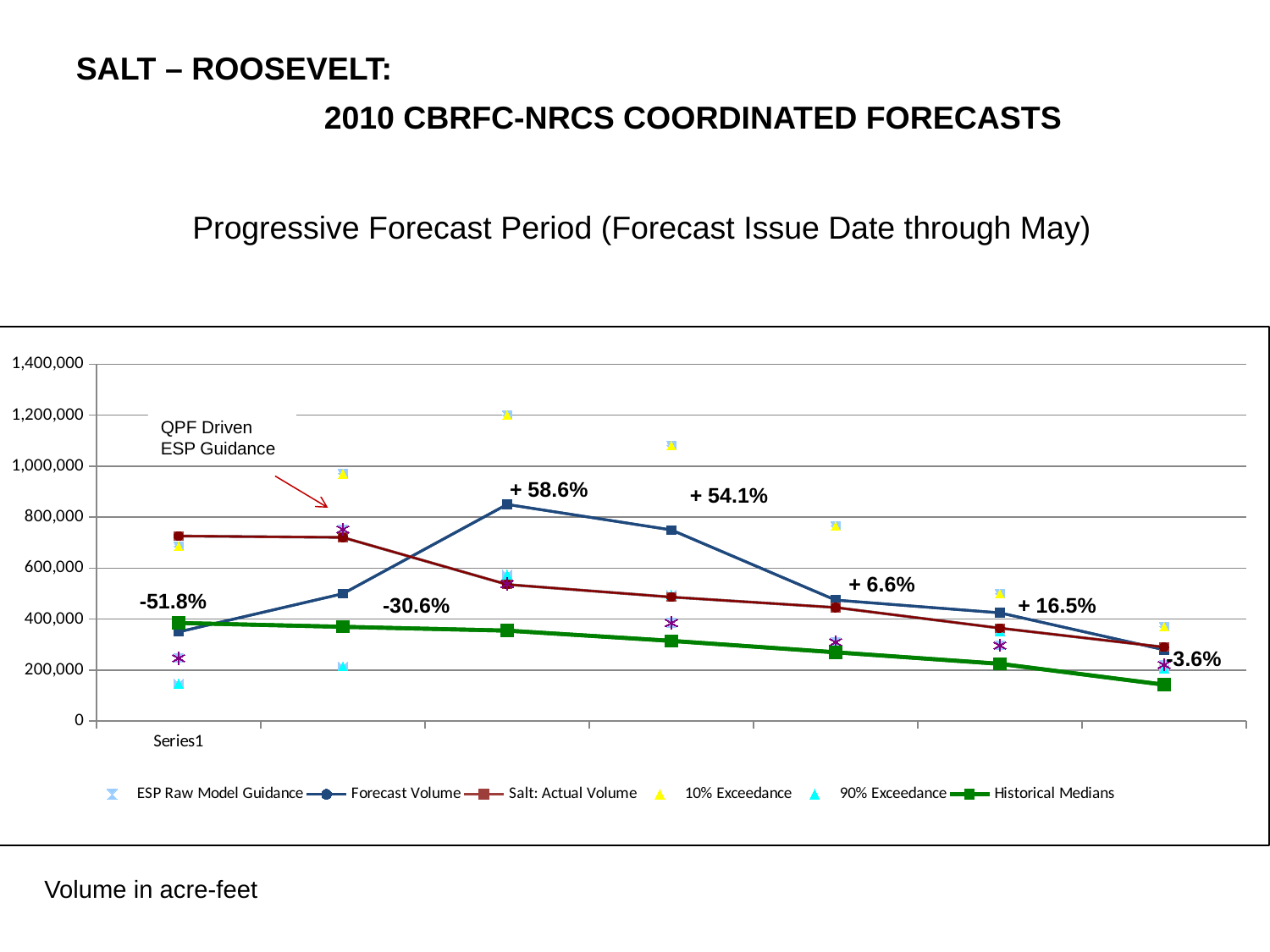
How many series does the legend list? 6 At the first point on the left, which is larger: Salt: Actual Volume or Forecast Volume? Salt: Actual Volume How many points are plotted along the Forecast Volume line? 7 What kind of chart is shown on the slide? line chart What is the highest value shown on the y axis? 1,400,000 What percentage label is printed above the peak of the Forecast Volume line? + 58.6% Is the first value of the Salt: Actual Volume line greater or less than 600,000? greater Is the peak value of the Forecast Volume line greater or less than 800,000? greater At the third point from the left, which is larger: Forecast Volume or Salt: Actual Volume? Forecast Volume Which series has the highest plotted point on the chart? 10% Exceedance Do the Historical Medians values rise or fall from left to right along the x axis? fall Is the last value of the Historical Medians line greater or less than 200,000? less